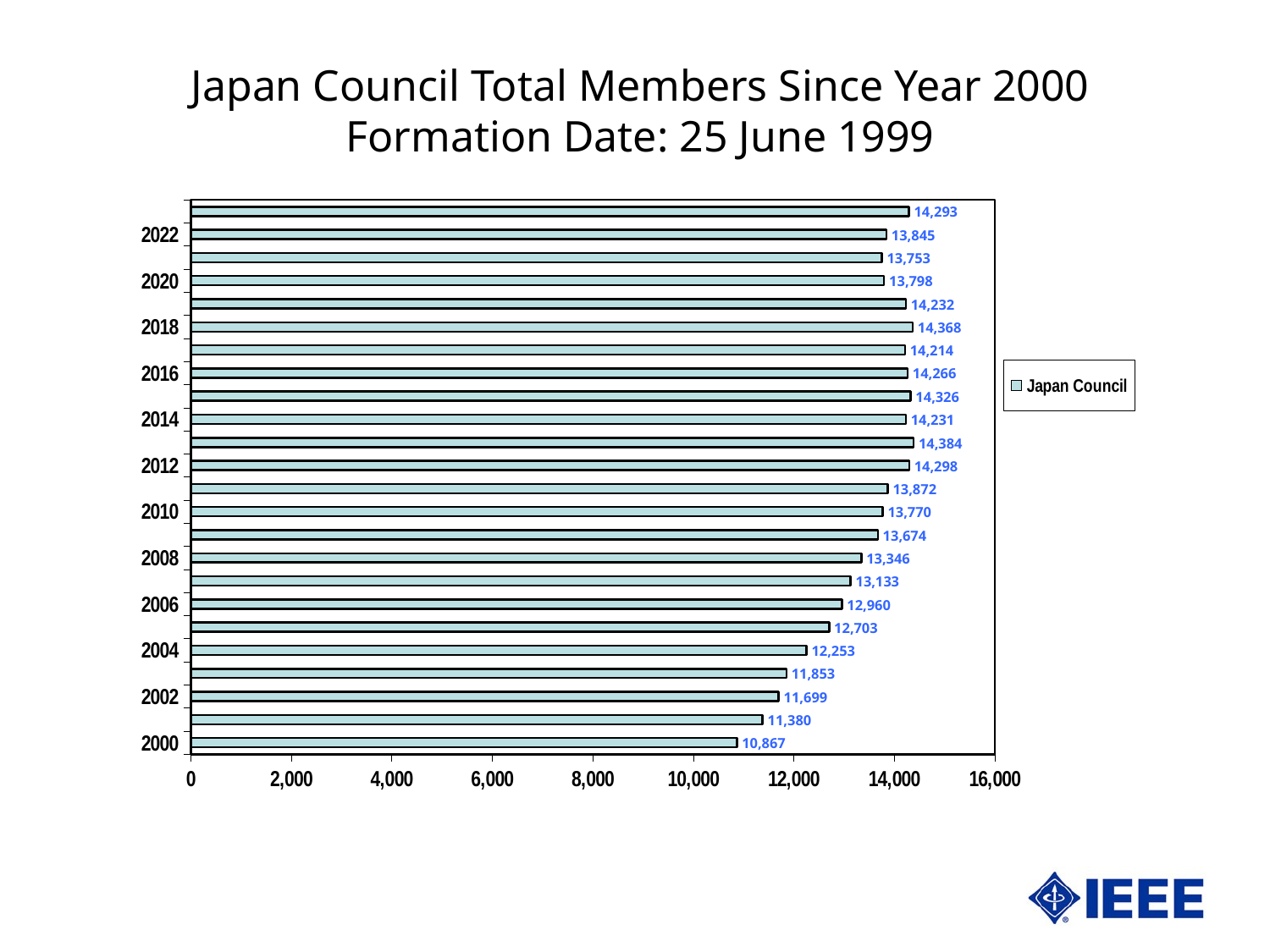
What is the value for 2000? 10,867 Which year has the lowest value? 2000 Is the value for 2004 greater or less than 12,000? greater What is the value for 2012? 14,298 How many bars are plotted on the chart? 24 What is the difference between the values for 2010 and 2008? 424 Which is larger, the value for 2018 or the value for 2020? 2018 What kind of chart is shown on the slide? bar chart What is the difference between the values for 2022 and 2000? 2,978 What is the highest value shown on the chart? 14,384 What is the value for 2022? 13,845 What is the value for 2006? 12,960